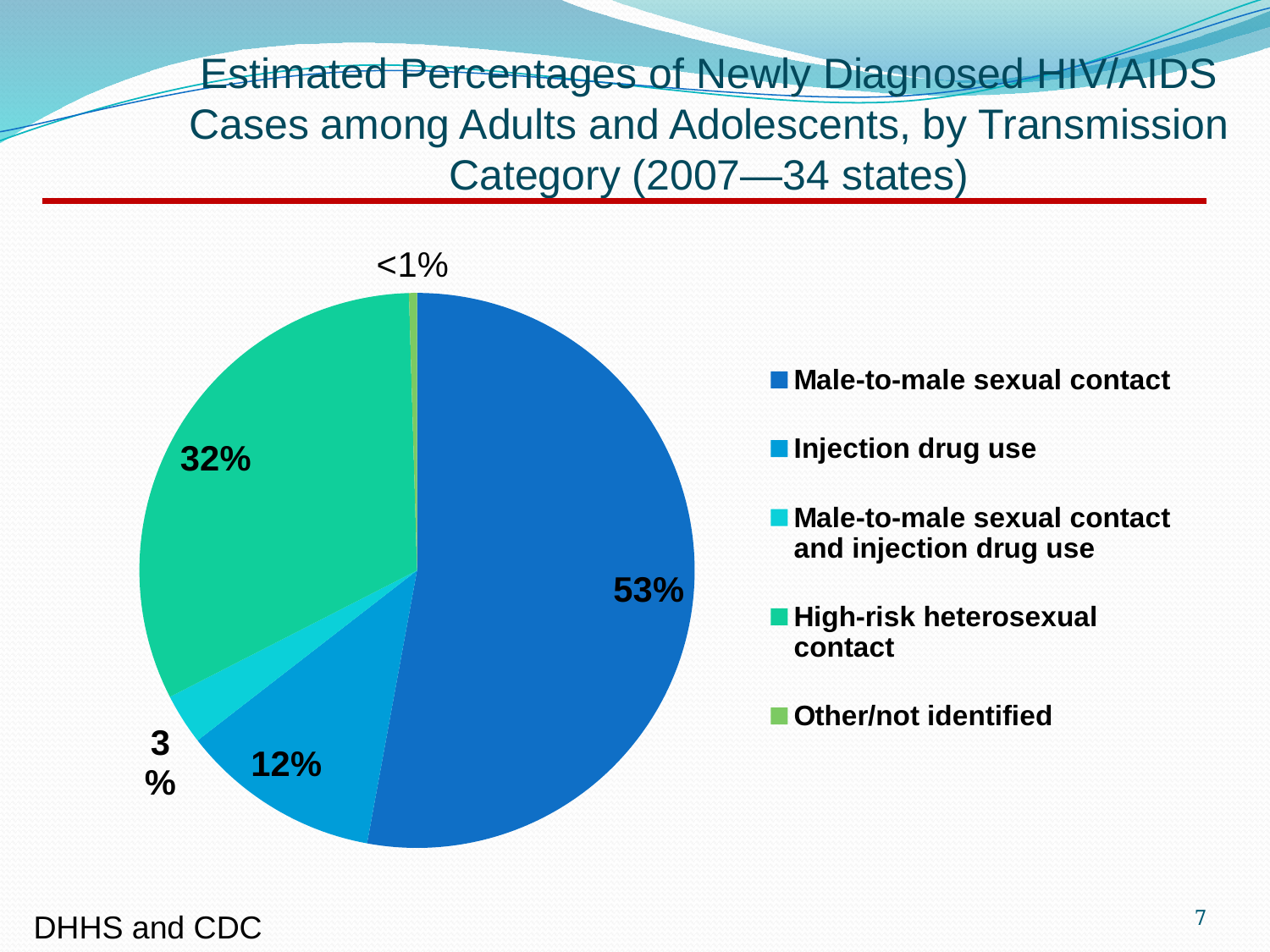
What source is cited at the bottom of the slide? DHHS and CDC What kind of chart is shown on the slide? Pie chart Which transmission category has the largest share of cases? Male-to-male sexual contact What percentage of cases is attributed to injection drug use? 12% What percentage of cases is attributed to male-to-male sexual contact and injection drug use? 3% What value is shown for the Other/not identified slice? <1% Which is larger: the share for injection drug use or the share for high-risk heterosexual contact? High-risk heterosexual contact What is the difference in percentage points between male-to-male sexual contact and high-risk heterosexual contact? 21 How many transmission categories does the legend list? 5 Which transmission category has the smallest share of cases? Other/not identified What percentage of cases is attributed to high-risk heterosexual contact? 32% What percentage of newly diagnosed HIV/AIDS cases is attributed to male-to-male sexual contact? 53%